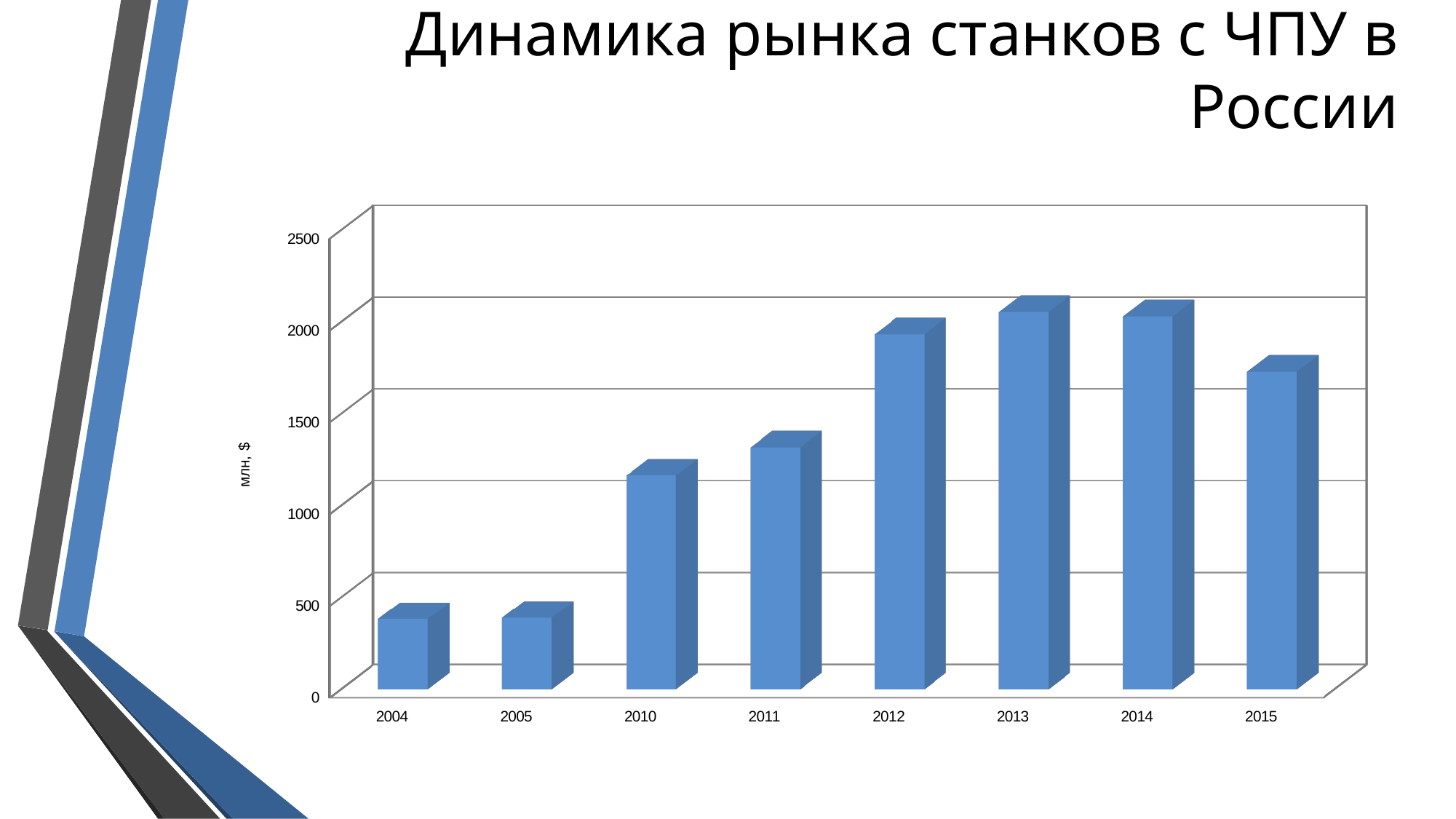
Is the value for 2010 greater or less than 1500? less Is the value for 2012 greater or less than 1500? greater What is the title of the slide containing the chart? Динамика рынка станков с ЧПУ в России What is the label on the vertical axis of the chart? млн, $ How many years are shown on the x axis of the chart? 8 Do the values rise or fall from 2004 to 2012? rise Is the value for 2015 greater or less than 2000? less Which year has the larger value, 2012 or 2004? 2012 Which year has the larger value, 2013 or 2015? 2013 What kind of chart is shown on the slide? Bar chart